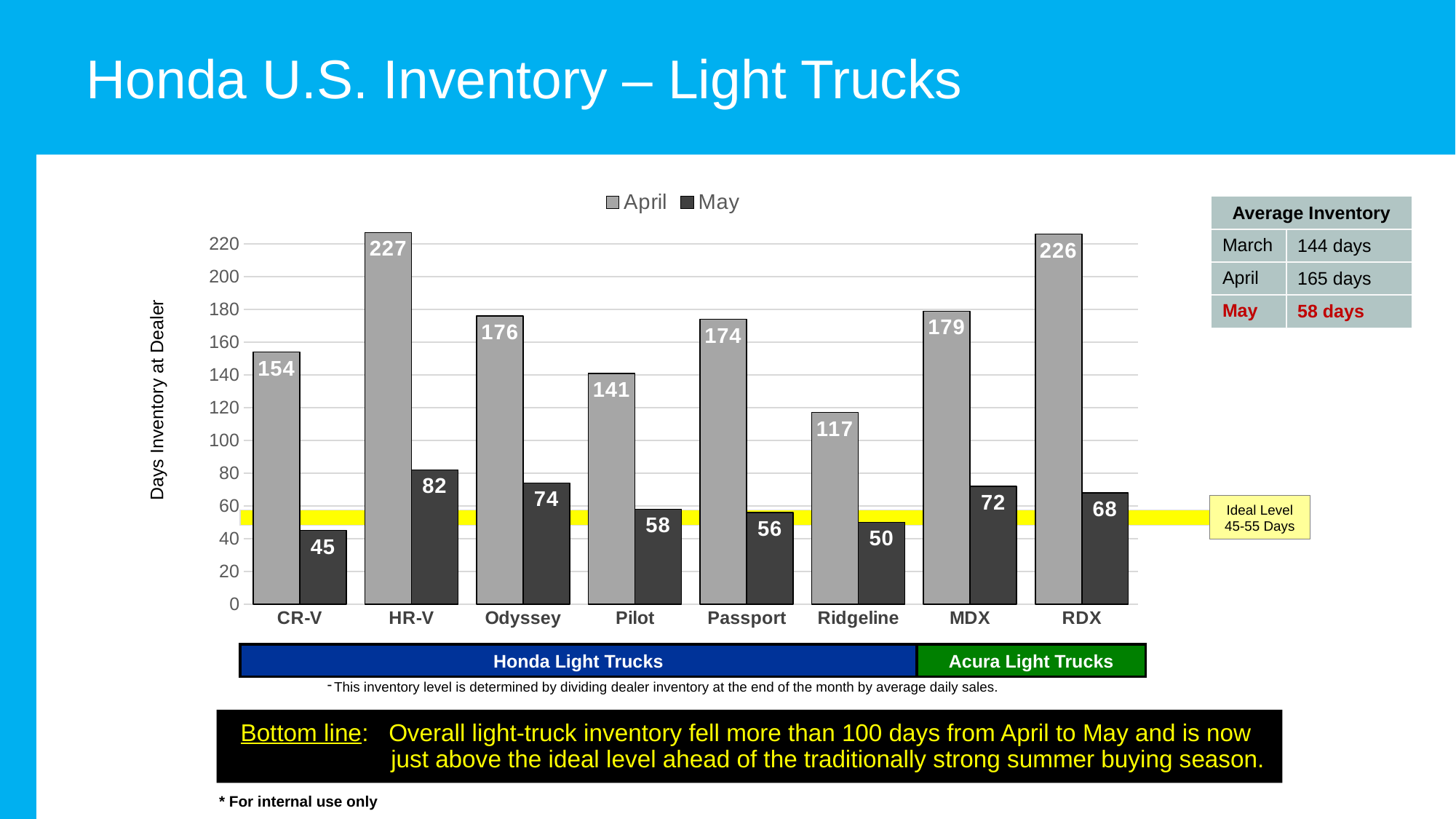
What is the April days inventory value for HR-V? 227 Which model has the highest April days inventory? HR-V What kind of chart is shown on the slide? bar chart Which model has the lowest May days inventory? CR-V Which is larger, the May value for MDX or the May value for RDX? MDX What is the label of the y axis of the chart? Days Inventory at Dealer Is the April value for Ridgeline greater or less than 100? greater How many models are shown on the x axis of the chart? 8 How many series does the chart legend list? 2 What is the May days inventory value for Ridgeline? 50 What is the difference between the April and May values for Pilot? 83 What is the difference between the April values for RDX and MDX? 47